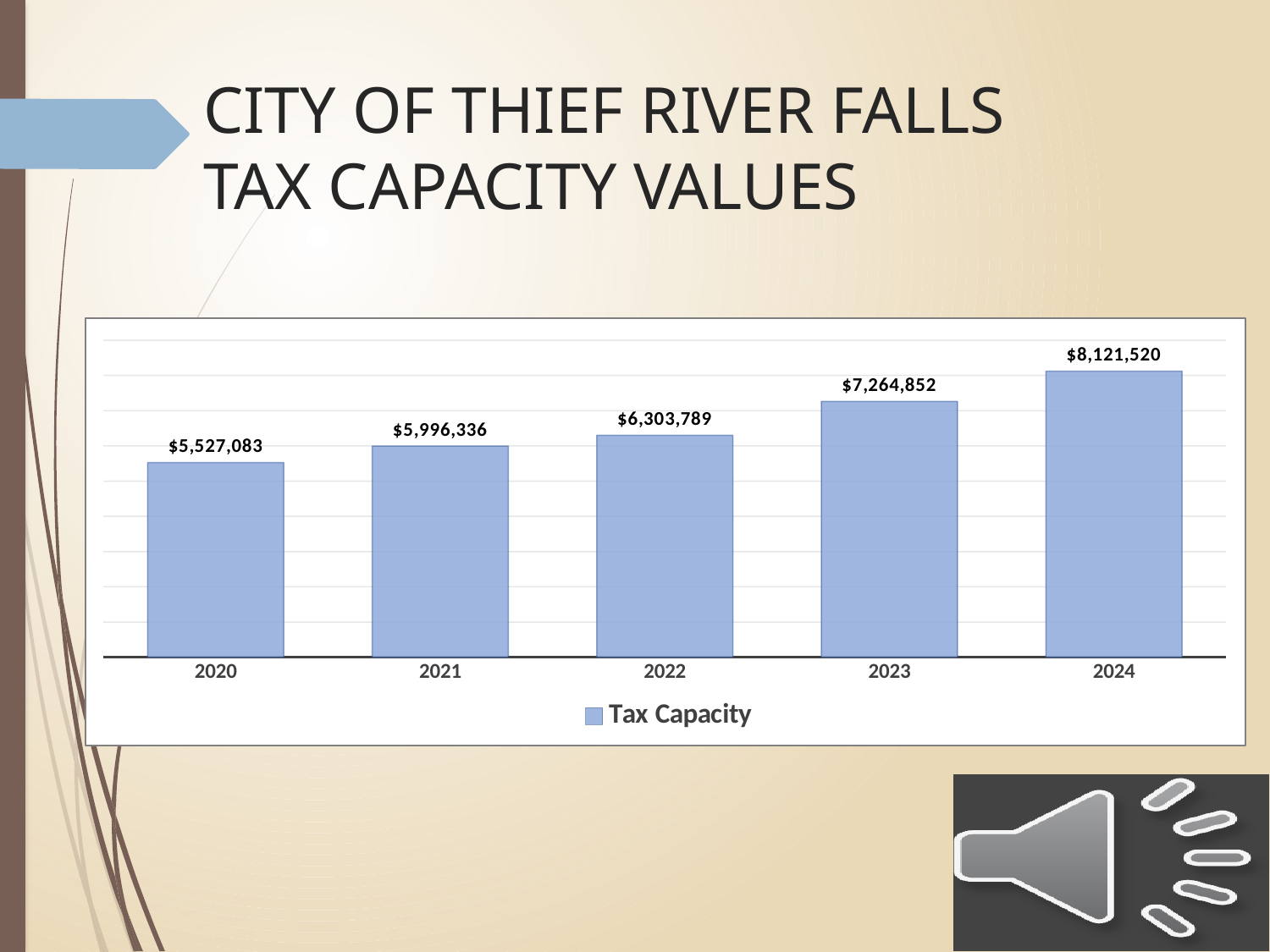
What is the tax capacity value for 2022? $6,303,789 What is the difference between the tax capacity values for 2023 and 2022? $961,063 How many series does the legend list? 1 Which year has the lowest tax capacity value? 2020 What is the tax capacity value for 2024? $8,121,520 How many years are shown on the chart? 5 Which year has the highest tax capacity value? 2024 Do the tax capacity values rise or fall from 2020 to 2024? Rise What kind of chart is shown on the slide? Bar chart What is the tax capacity value for 2020? $5,527,083 What is the difference between the tax capacity values for 2024 and 2020? $2,594,437 Which year has a larger tax capacity value, 2021 or 2023? 2023